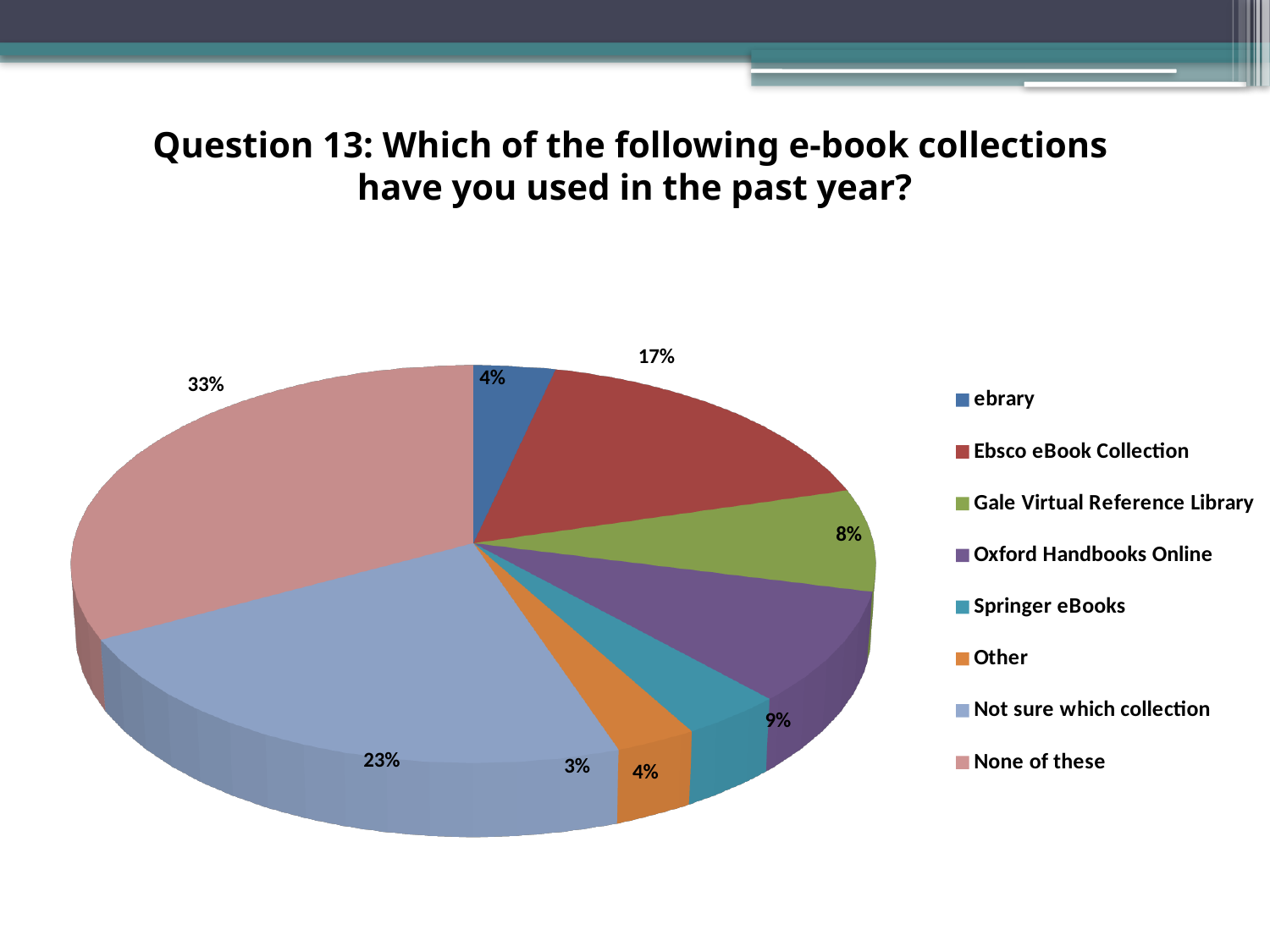
What percentage is shown for Gale Virtual Reference Library? 8% What percentage of respondents selected "None of these"? 33% What colour is the slice for "None of these"? pink Which category has the largest slice of the pie? None of these What percentage is shown for Oxford Handbooks Online? 9% Which is larger, the share for Ebsco eBook Collection or the share for Oxford Handbooks Online? Ebsco eBook Collection What kind of chart is shown on the slide? pie chart What percentage is shown for "Not sure which collection"? 23% How many categories does the legend list? 8 What percentage is shown for Ebsco eBook Collection? 17% Which category has the smallest slice of the pie? Other What is the difference in percentage points between "None of these" and "Not sure which collection"? 10